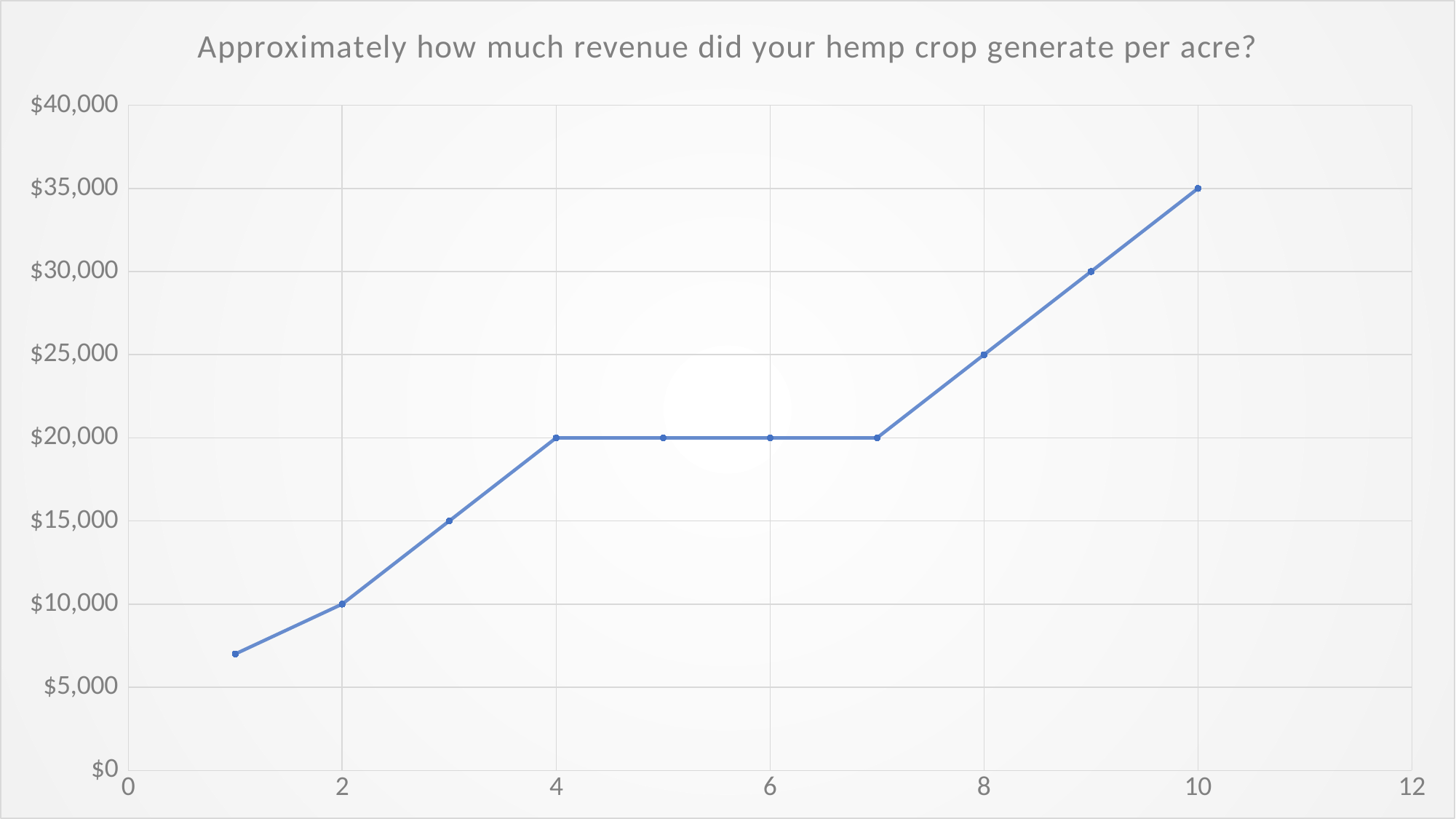
Do the values generally rise or fall as x increases? Rise Is the value at x = 1 greater or less than $10,000? less What is the value at x = 2? $10,000 At which x value is the plotted value highest? 10 What is the title of the chart? Approximately how much revenue did your hemp crop generate per acre? What kind of chart is shown on the slide? Line chart What is the value at x = 10? $35,000 How many data points are plotted on the line? 10 What is the value at x = 3? $15,000 What is the value at x = 8? $25,000 What is the value at x = 4? $20,000 What is the difference between the values at x = 10 and x = 2? $25,000